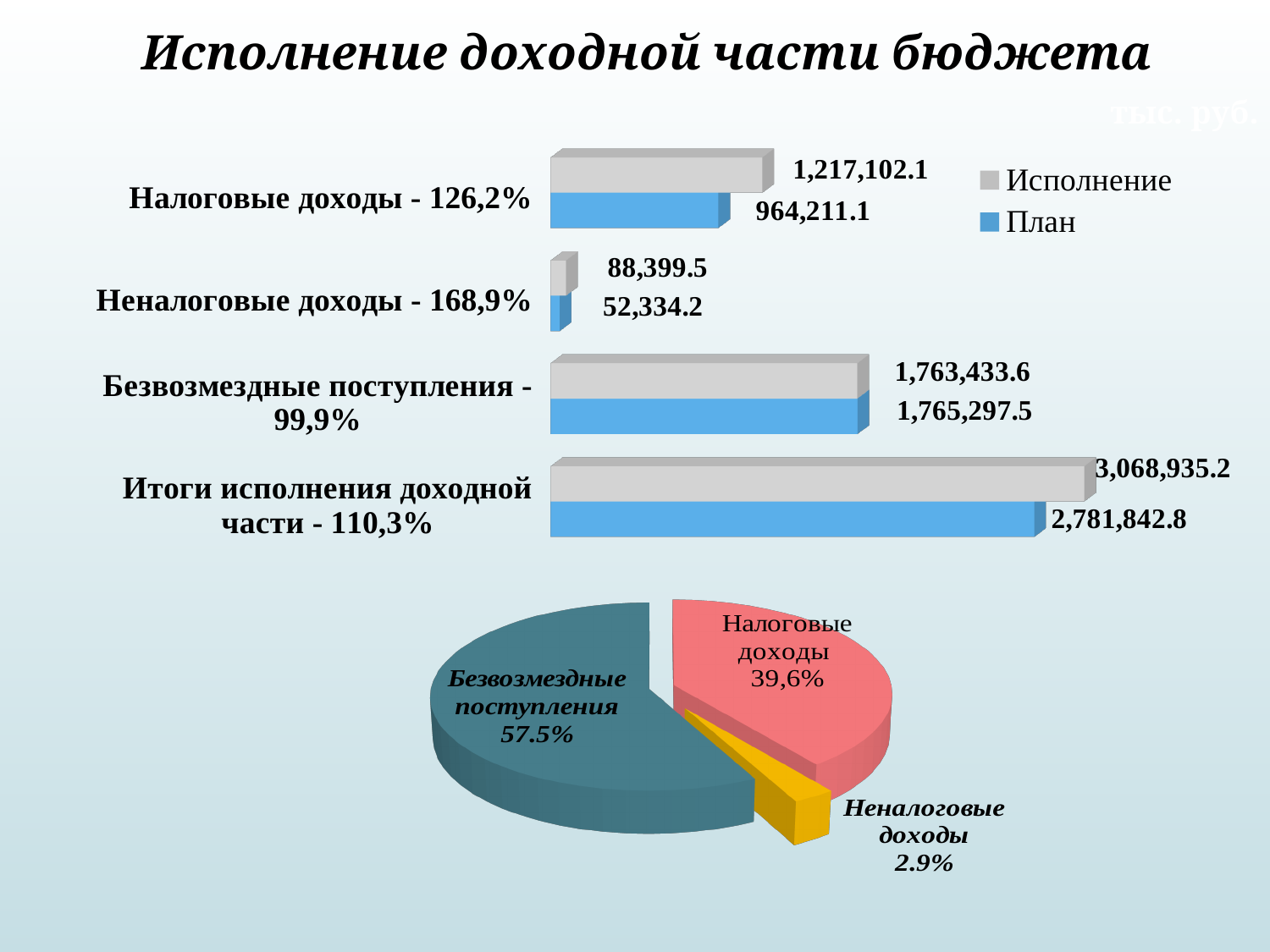
In the bar chart, which category has the lowest Исполнение value? Неналоговые доходы What type of chart is the bottom chart on the slide? Pie chart In the bar chart, what is the Исполнение value for Налоговые доходы? 1,217,102.1 In the bar chart, what is the difference between the Исполнение and План values for Налоговые доходы? 252,891.0 In the pie chart, which slice is the smallest? Неналоговые доходы In the bar chart, what is the difference between the Исполнение and План values for Итоги исполнения доходной части? 287,092.4 In the pie chart, what share does Безвозмездные поступления have? 57.5% In the bar chart, what is the Исполнение value for Итоги исполнения доходной части? 3,068,935.2 How many series does the legend of the bar chart list? 2 In the bar chart, what is the План value for Безвозмездные поступления? 1,765,297.5 In the bar chart, what is the План value for Неналоговые доходы? 52,334.2 In the bar chart, which is larger for Неналоговые доходы: Исполнение or План? Исполнение